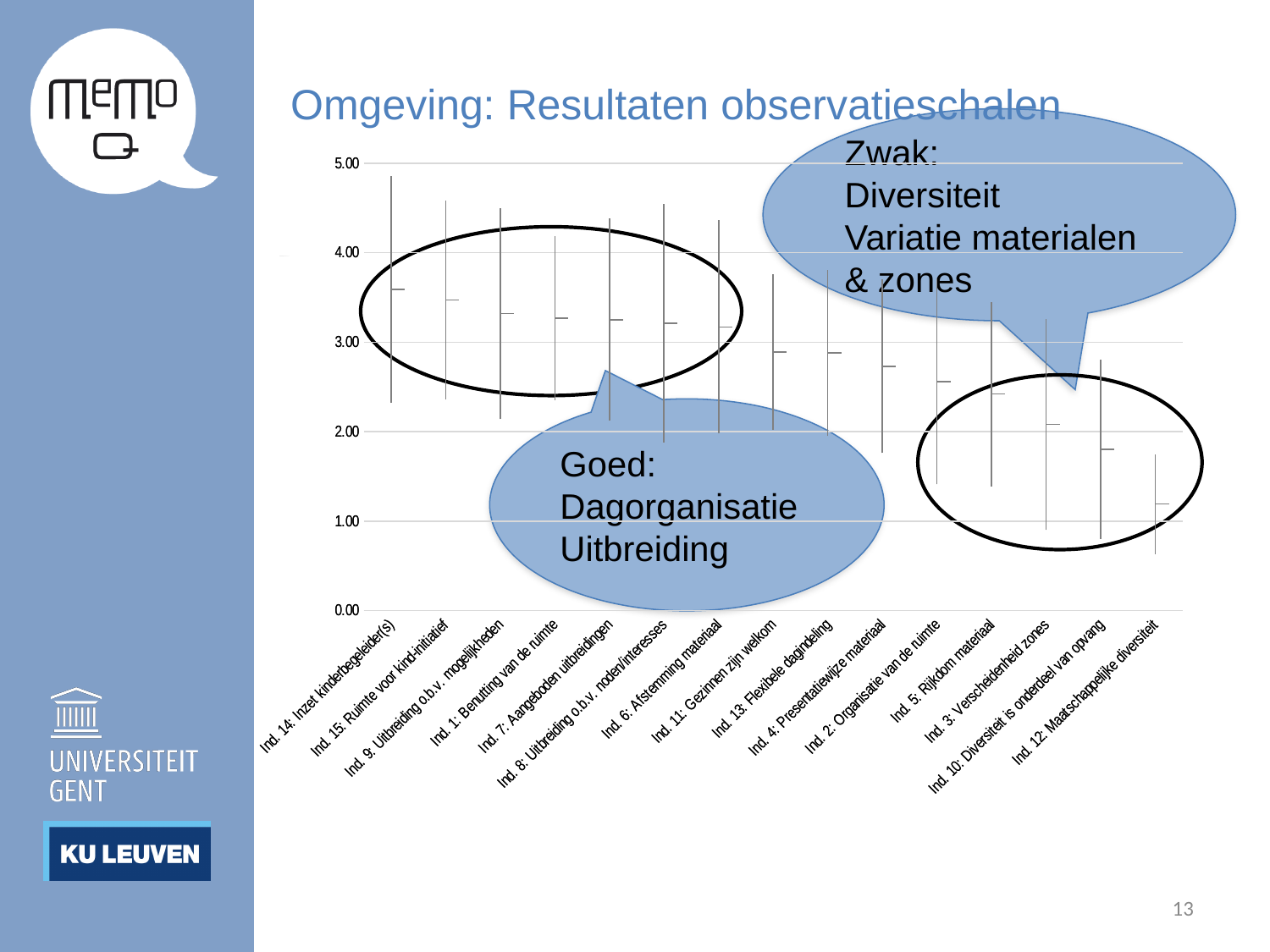
Do the mean values generally rise or fall moving from left to right along the x axis? fall Is the mean value for Ind. 10: Diversiteit is onderdeel van opvang greater or less than 2.00? less What is the title of the slide containing the chart? Omgeving: Resultaten observatieschalen Which has the higher mean value: Ind. 5: Rijkdom materiaal or Ind. 10: Diversiteit is onderdeel van opvang? Ind. 5: Rijkdom materiaal Which indicator has the lowest mean value on the chart? Ind. 12: Maatschappelijke diversiteit Which has the higher mean value: Ind. 14: Inzet kinderbegeleider(s) or Ind. 12: Maatschappelijke diversiteit? Ind. 14: Inzet kinderbegeleider(s) What is the maximum value shown on the chart's y axis? 5.00 How many indicators (categories) are plotted along the x axis of the chart? 15 Is the mean value for Ind. 12: Maatschappelijke diversiteit greater or less than 2.00? less Is the mean value for Ind. 2: Organisatie van de ruimte greater or less than 3.00? less